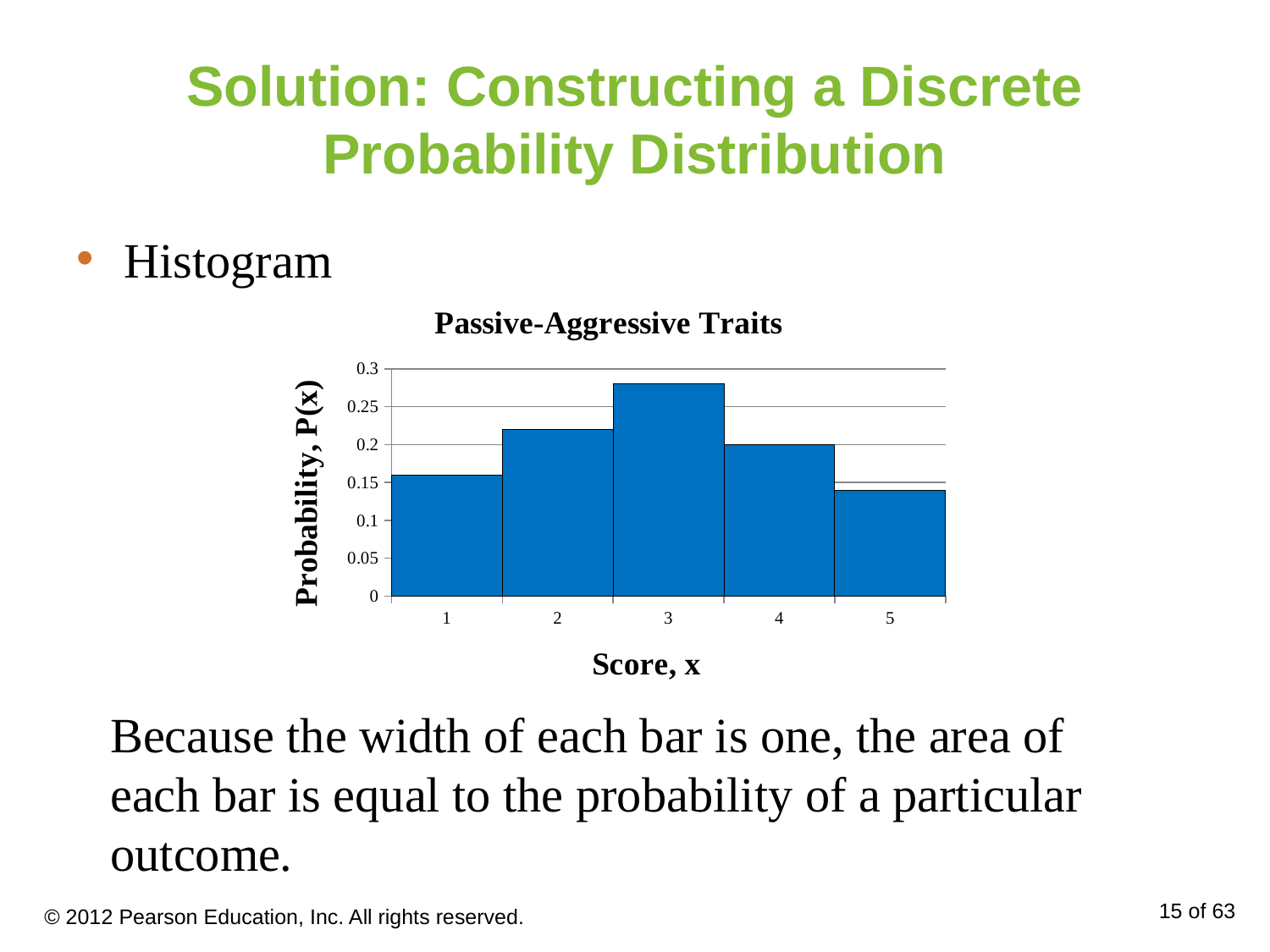
What is the label of the vertical axis? Probability, P(x) How many bars (score categories) does the chart show? 5 Which score has the lowest probability? 5 Do the probabilities rise or fall from score 3 to score 5? fall Is the probability for score 3 greater or less than 0.25? greater Is the probability for score 1 greater or less than 0.2? less Is the probability for score 5 greater or less than 0.1? greater What is the title of the chart? Passive-Aggressive Traits Which has the larger probability, score 3 or score 1? score 3 What kind of chart is shown on the slide? bar chart Which score has the highest probability? 3 What is the probability P(x) for score 4? 0.2